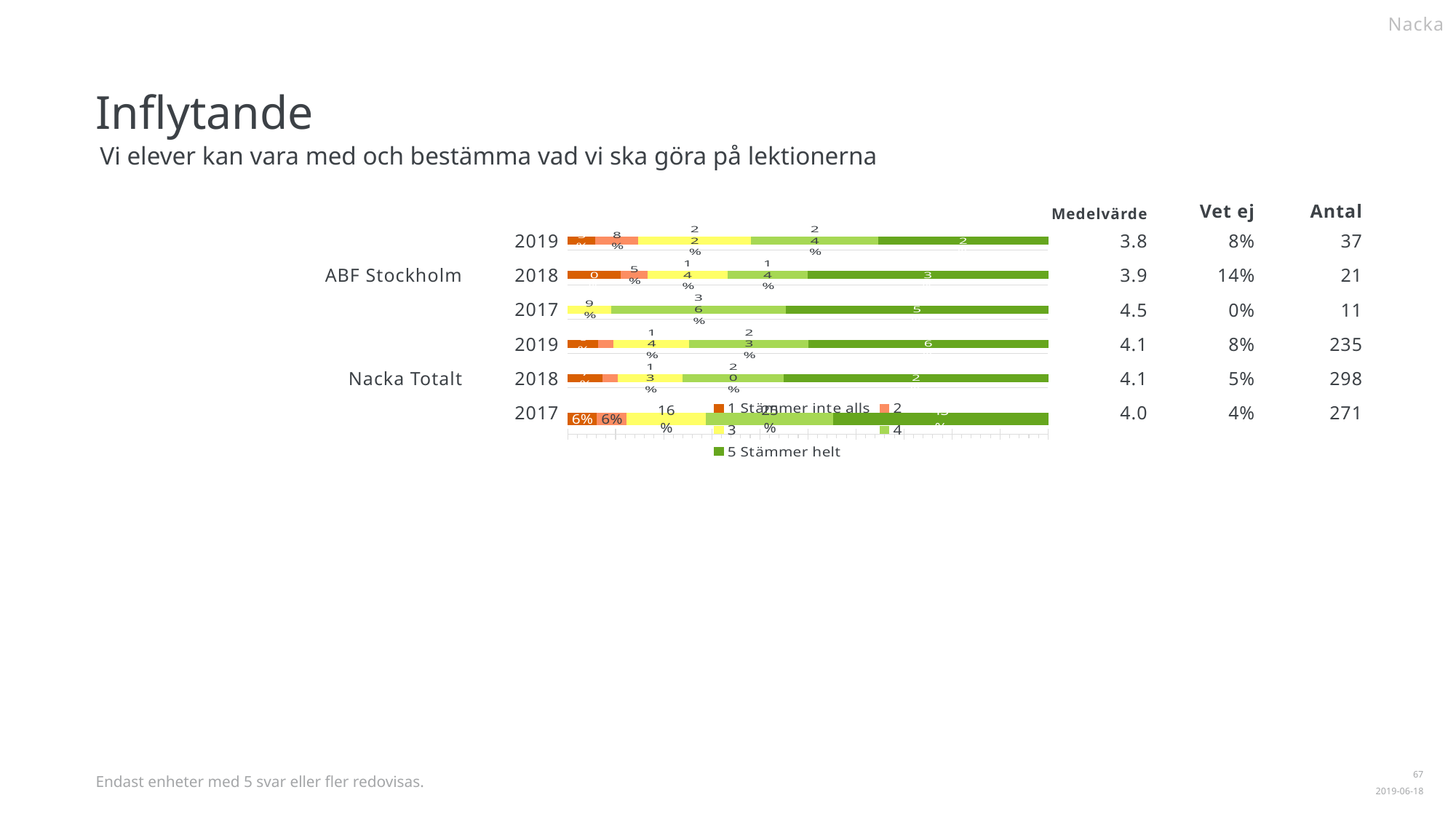
What is the value of the '3' segment for ABF Stockholm 2017? 9% What is the last entry in the chart legend? 5 Stämmer helt What is the first entry in the chart legend? 1 Stämmer inte alls How many bars are plotted in the chart? 6 What is the value of the '3' segment for Nacka Totalt 2017? 16% What is the value of the '1 Stämmer inte alls' segment for Nacka Totalt 2017? 6% What kind of chart is shown on the slide? Stacked bar chart How many series does the chart legend list? 5 What is the value of the '2' segment for ABF Stockholm 2019? 8% For Nacka Totalt 2017, which segment is larger: '3' or '5 Stämmer helt'? 5 Stämmer helt Which bar has the smallest '5 Stämmer helt' segment? ABF Stockholm 2019 What is the Medelvärde shown for ABF Stockholm 2017? 4.5